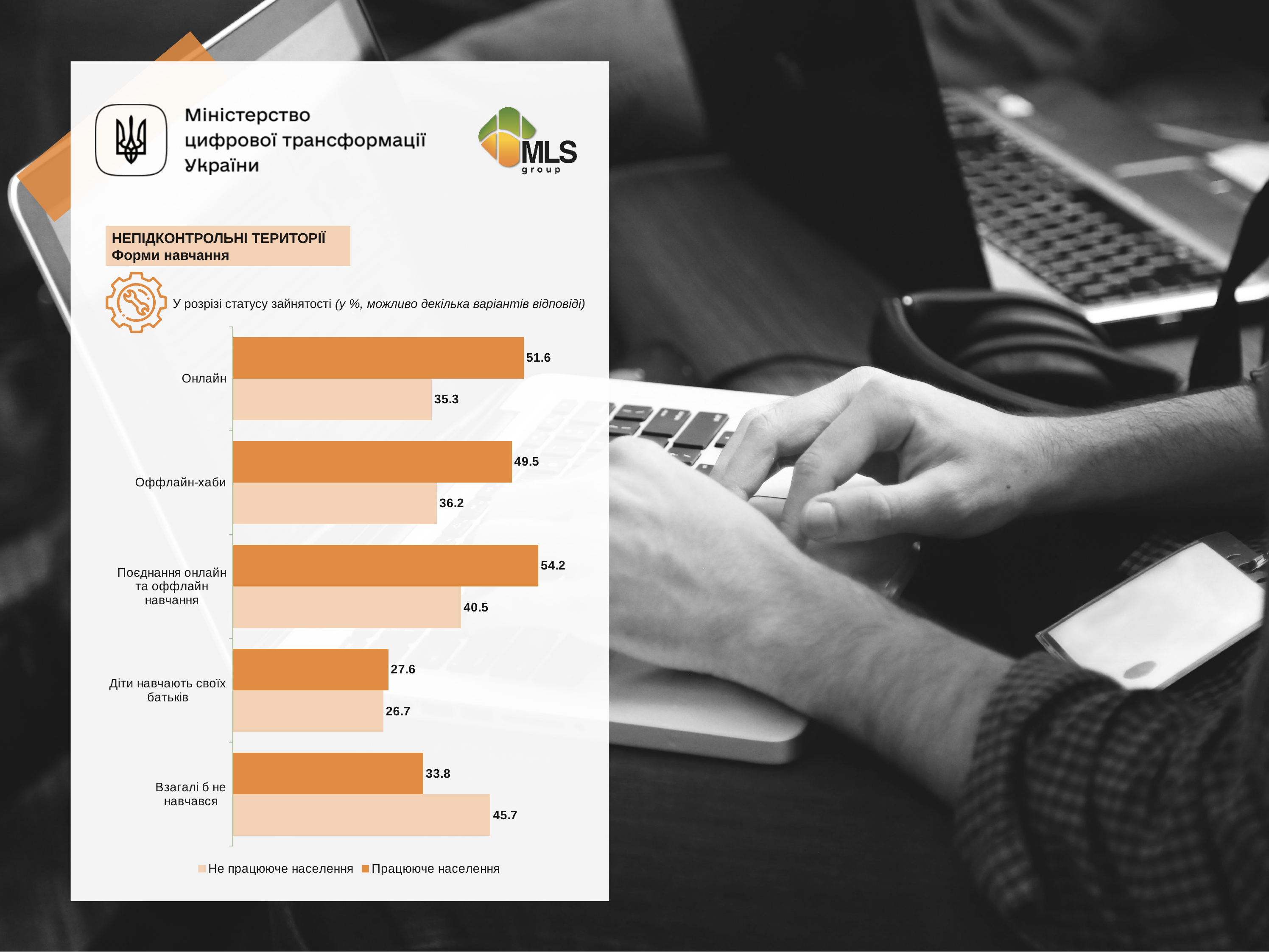
In the "Взагалі б не навчався" category, which series has the larger value: "Працююче населення" or "Не працююче населення"? Не працююче населення What is the value for "Не працююче населення" in the "Взагалі б не навчався" category? 45.7 What kind of chart is shown on the slide? Bar chart What is the difference between "Працююче населення" and "Не працююче населення" in the "Онлайн" category? 16.3 Which category has the lowest value for "Не працююче населення"? Діти навчають своїх батьків What is the difference between "Працююче населення" and "Не працююче населення" in the "Поєднання онлайн та оффлайн навчання" category? 13.7 What is the value for "Працююче населення" in the "Онлайн" category? 51.6 How many categories are shown on the chart? 5 Which category has the highest value for "Працююче населення"? Поєднання онлайн та оффлайн навчання Which series is shown in the darker orange colour? Працююче населення How many series does the legend list? 2 What is the value for "Не працююче населення" in the "Оффлайн-хаби" category? 36.2